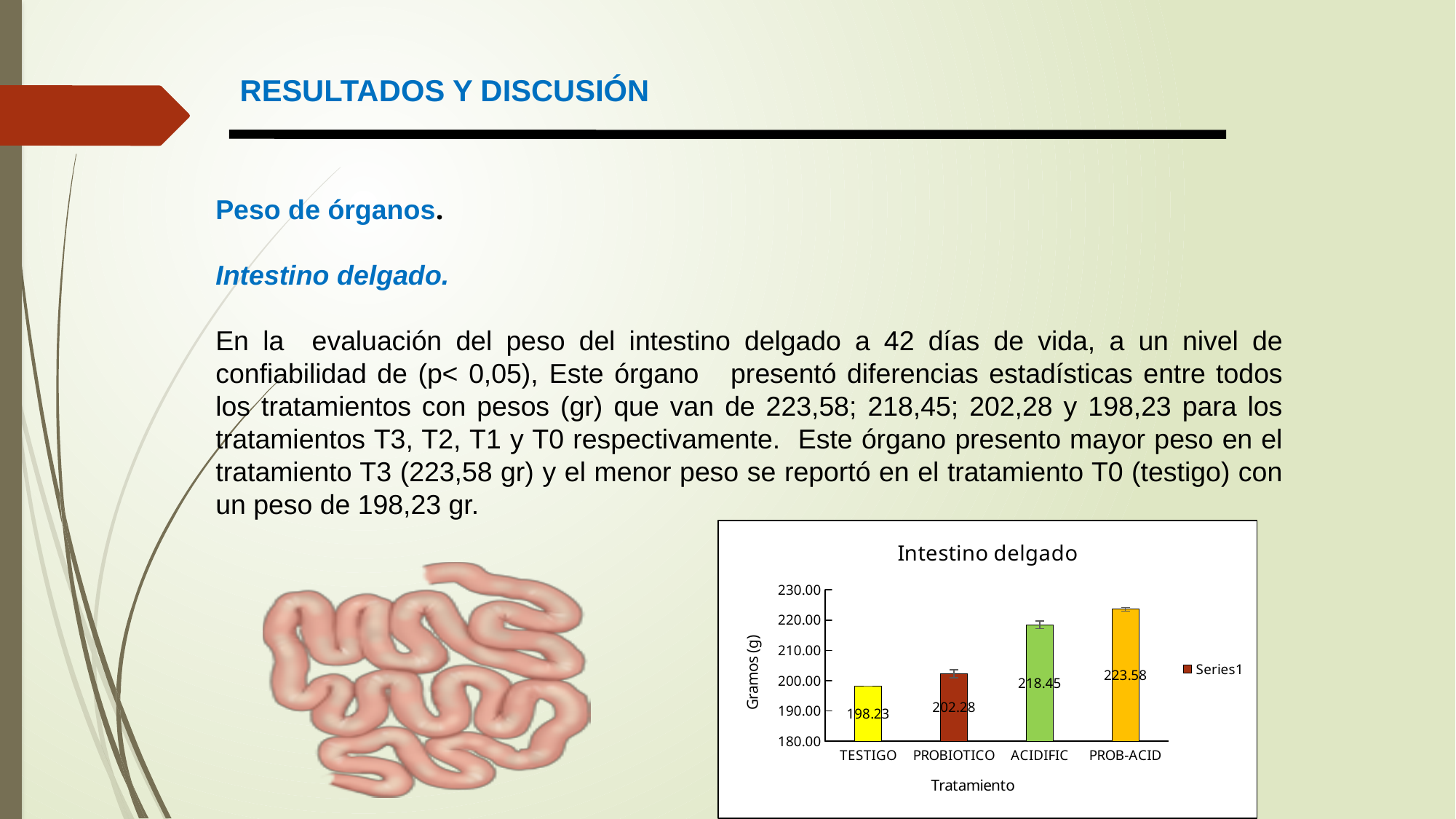
What kind of chart is the Intestino delgado chart? bar chart Which is larger in the Intestino delgado chart, ACIDIFIC or PROBIOTICO? ACIDIFIC What is the value for PROB-ACID in the Intestino delgado chart? 223.58 How many treatments are shown on the x axis of the Intestino delgado chart? 4 Which treatment has the highest value in the Intestino delgado chart? PROB-ACID What is the value for ACIDIFIC in the Intestino delgado chart? 218.45 Which treatment has the lowest value in the Intestino delgado chart? TESTIGO What is the value for PROBIOTICO in the Intestino delgado chart? 202.28 What is the value for TESTIGO in the Intestino delgado chart? 198.23 Is the value for PROBIOTICO greater or less than 210.00 in the Intestino delgado chart? less What is the difference between the PROB-ACID and TESTIGO values in the Intestino delgado chart? 25.35 What is the y-axis label of the Intestino delgado chart? Gramos (g)